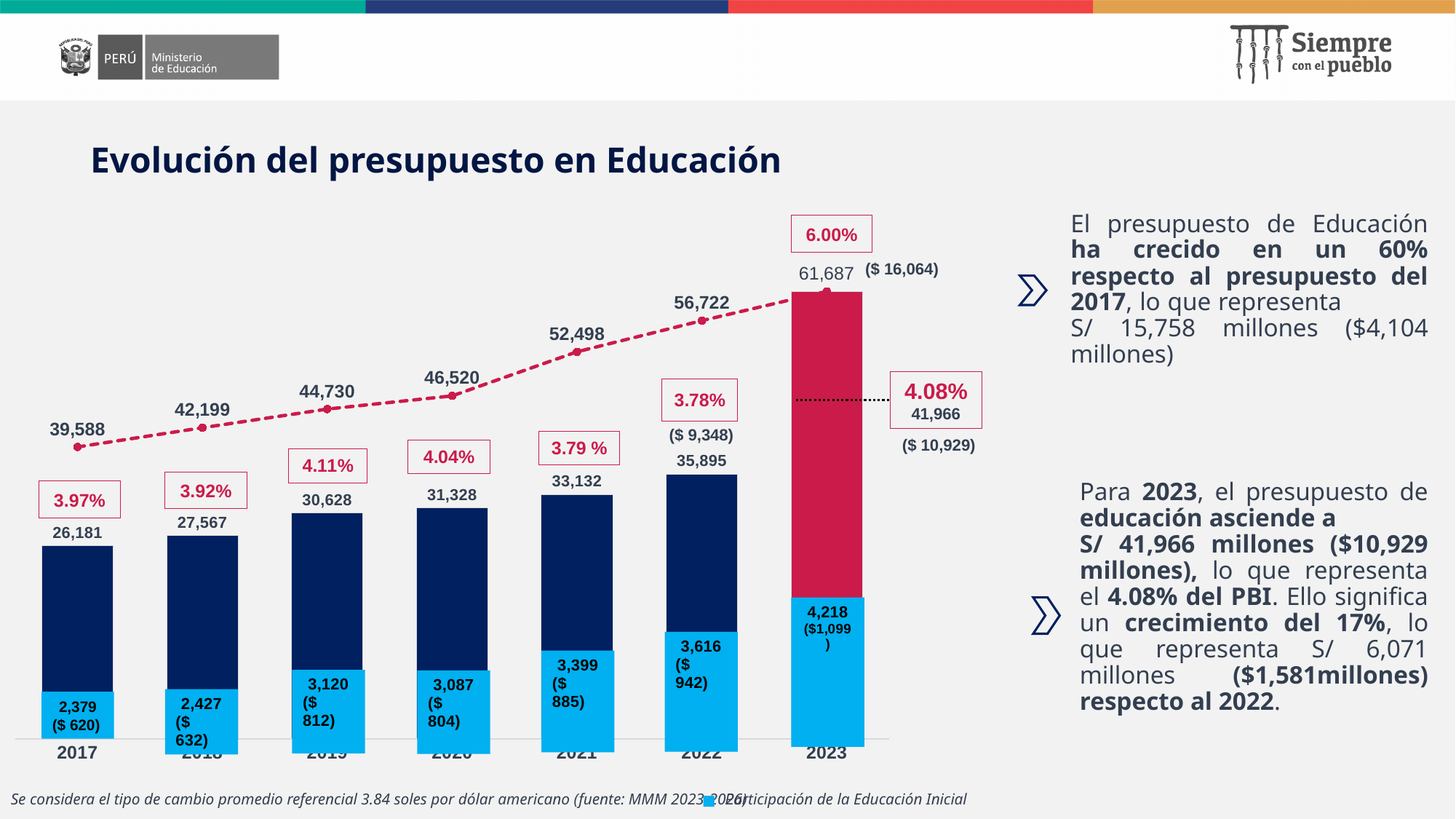
Which is larger, the light blue segment for 2019 or for 2020? 2019 Which year has the lowest value for the light blue (Educación Inicial) segment? 2017 What percentage is shown in the box above the 2019 bar? 4.11% What is the difference between the bar totals for 2022 and 2021? 2,763 How many years are shown on the x axis of the chart? 7 What is the difference between the dashed line values for 2023 and 2017? 22,099 What kind of chart is shown on the slide? bar chart with a line What value does the dashed line show for 2020? 46,520 Does the dashed line rise or fall from 2017 to 2023? rise In which year does the dashed line reach its highest value? 2023 What is the value of the light blue (Educación Inicial) segment for 2021? 3,399 What value is labelled at the top of the bar for 2022? 35,895